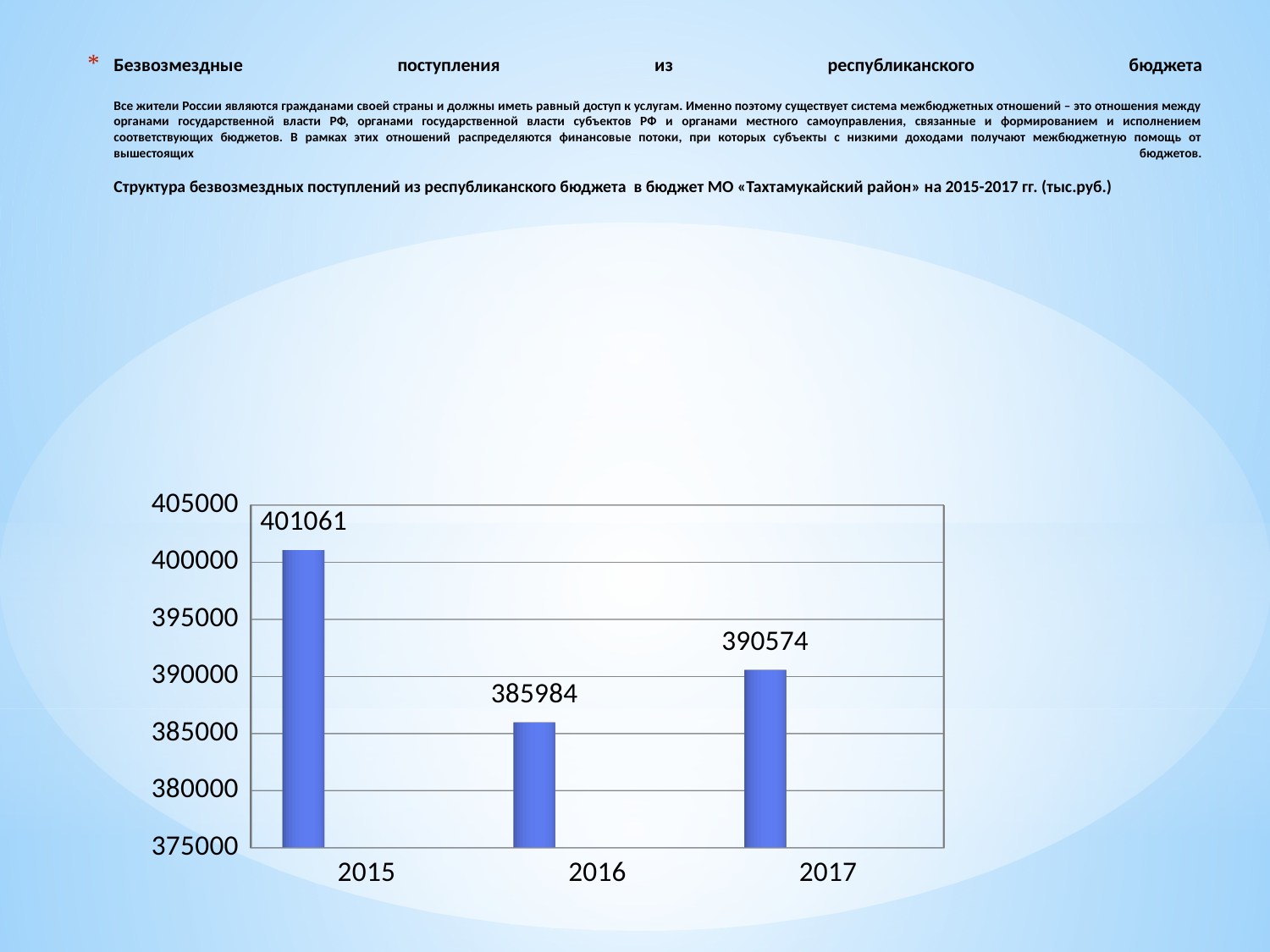
What kind of chart is shown on the slide? bar chart What is the value for 2017? 390574 How many years are shown on the chart? 3 What is the difference between the values for 2017 and 2016? 4590 Which year has the lowest value? 2016 What is the value for 2016? 385984 Does the value rise or fall from 2015 to 2016? fall Which is larger, the value for 2016 or the value for 2017? 2017 Is the value for 2015 greater or less than 400000? greater What is the value for 2015? 401061 Which year has the highest value? 2015 What is the difference between the values for 2015 and 2016? 15077